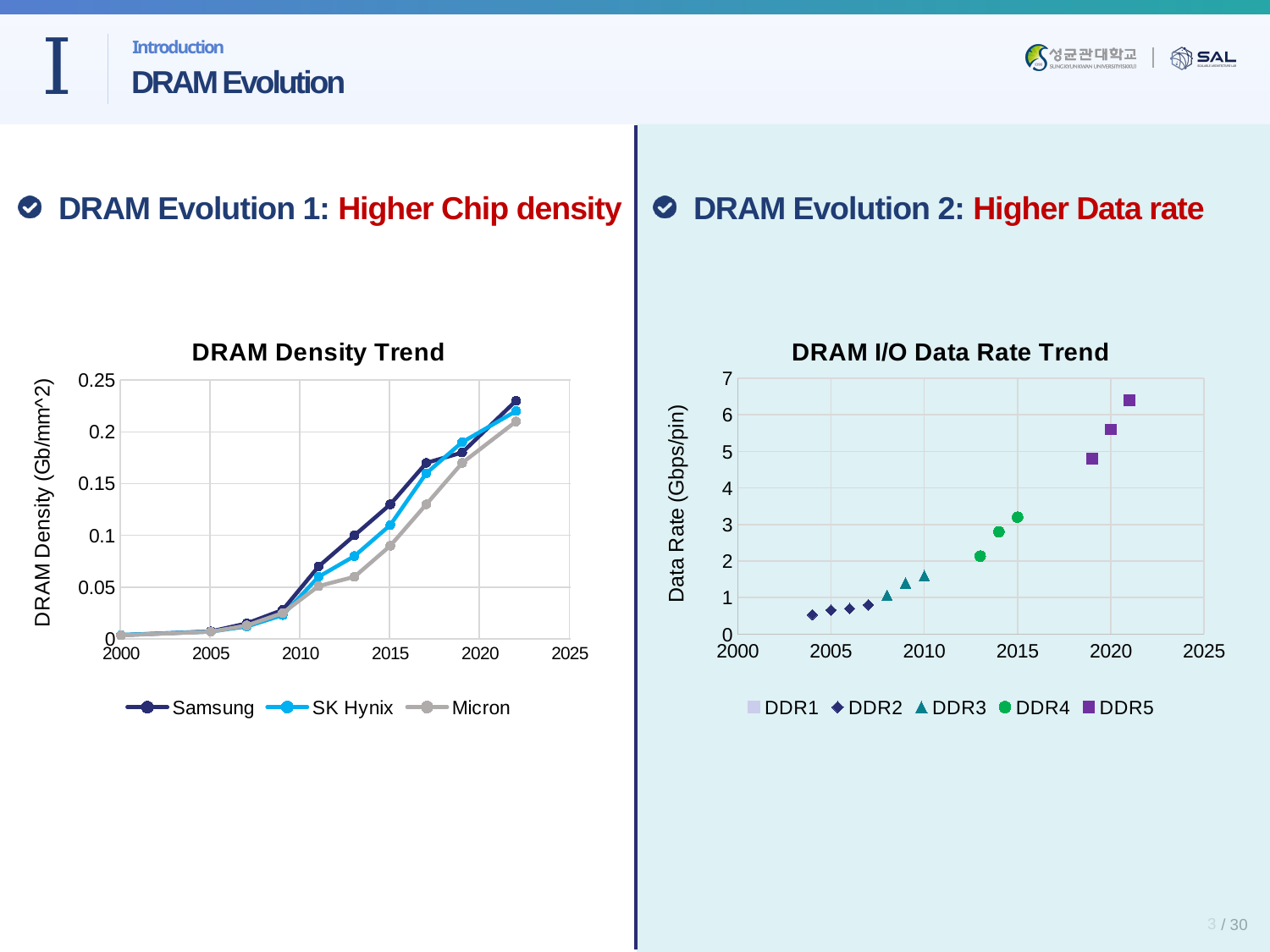
In the DRAM Density Trend chart, is the Samsung value at 2015 greater or less than 0.1? greater In the DRAM Density Trend chart, which series has the lowest value at 2015? Micron In the DRAM Density Trend chart, do the values rise or fall from 2000 to 2022? rise In the DRAM Density Trend chart, which is larger at 2017, Samsung or Micron? Samsung In the DRAM Density Trend chart, is the Micron value at 2015 greater or less than 0.1? less How many DDR5 points are plotted in the DRAM I/O Data Rate Trend chart? 3 What is the y-axis label of the DRAM Density Trend chart? DRAM Density (Gb/mm^2) In the DRAM I/O Data Rate Trend chart, which series has the highest data rate? DDR5 In the DRAM I/O Data Rate Trend chart, is the DDR5 value at 2021 greater or less than 6? greater How many series does the legend of the DRAM I/O Data Rate Trend chart list? 5 How many series does the legend of the DRAM Density Trend chart list? 3 What type of chart is the DRAM Density Trend chart on the left? line chart